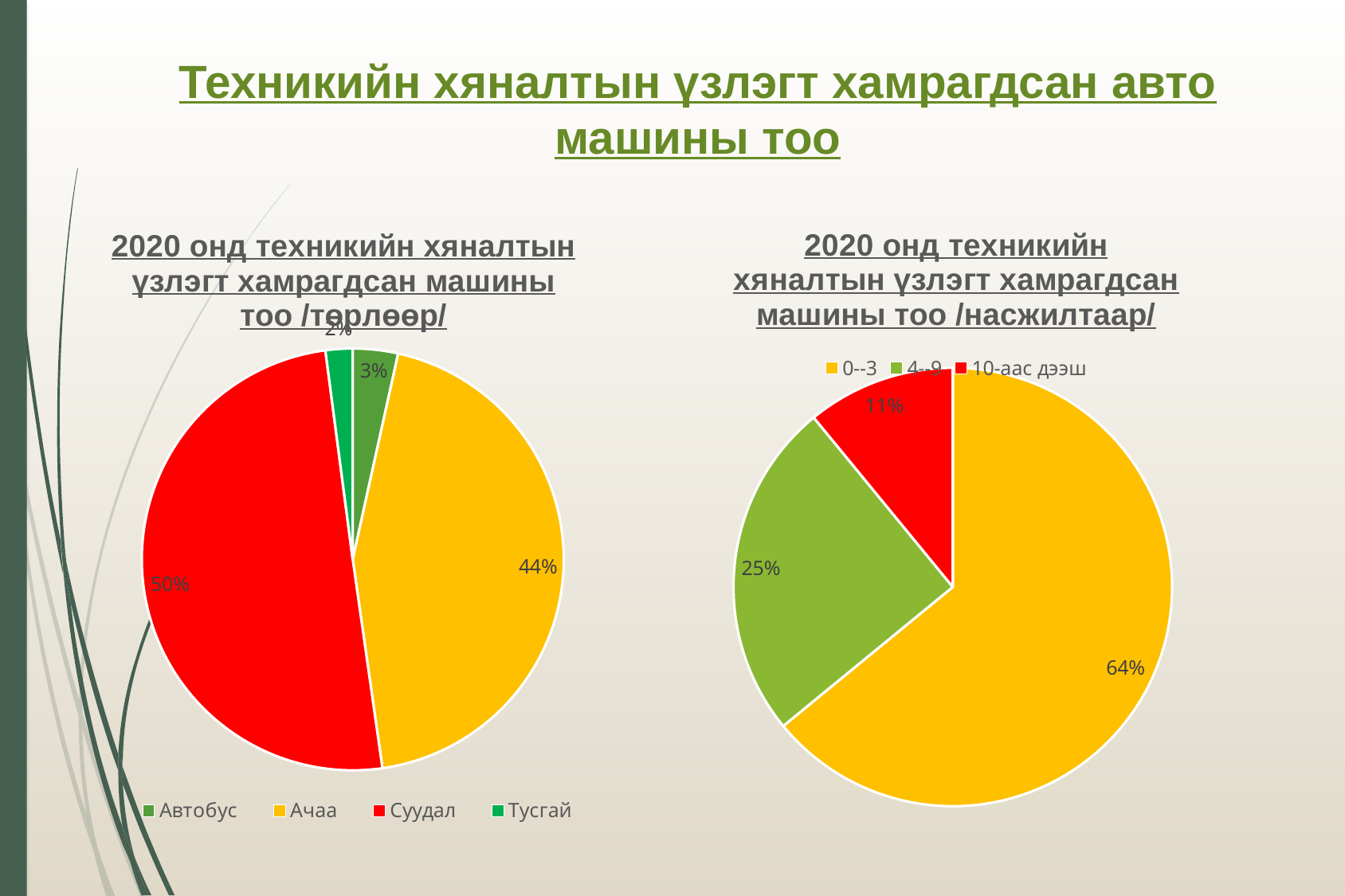
In the right chart (/насжилтаар/), what share does the 0--3 group have? 64% In the left chart (/төрлөөр/), which category has the smallest share? Тусгай In the right chart (/насжилтаар/), what is the difference between the 0--3 share and the 4--9 share? 39% In the left chart (/төрлөөр/), how many categories does the legend list? 4 In the right chart (/насжилтаар/), what colour is the 4--9 slice? Green In the left chart (/төрлөөр/), what share does Автобус have? 3% In the right chart (/насжилтаар/), what share does the 10-аас дээш group have? 11% In the right chart (/насжилтаар/), which group has the largest share? 0--3 In the left chart (/төрлөөр/), what share does Ачаа have? 44% In the left chart (/төрлөөр/), which category has the largest share? Суудал In the left chart (/төрлөөр/), what share does Суудал have? 50% What kind of chart is the right chart (/насжилтаар/)? Pie chart